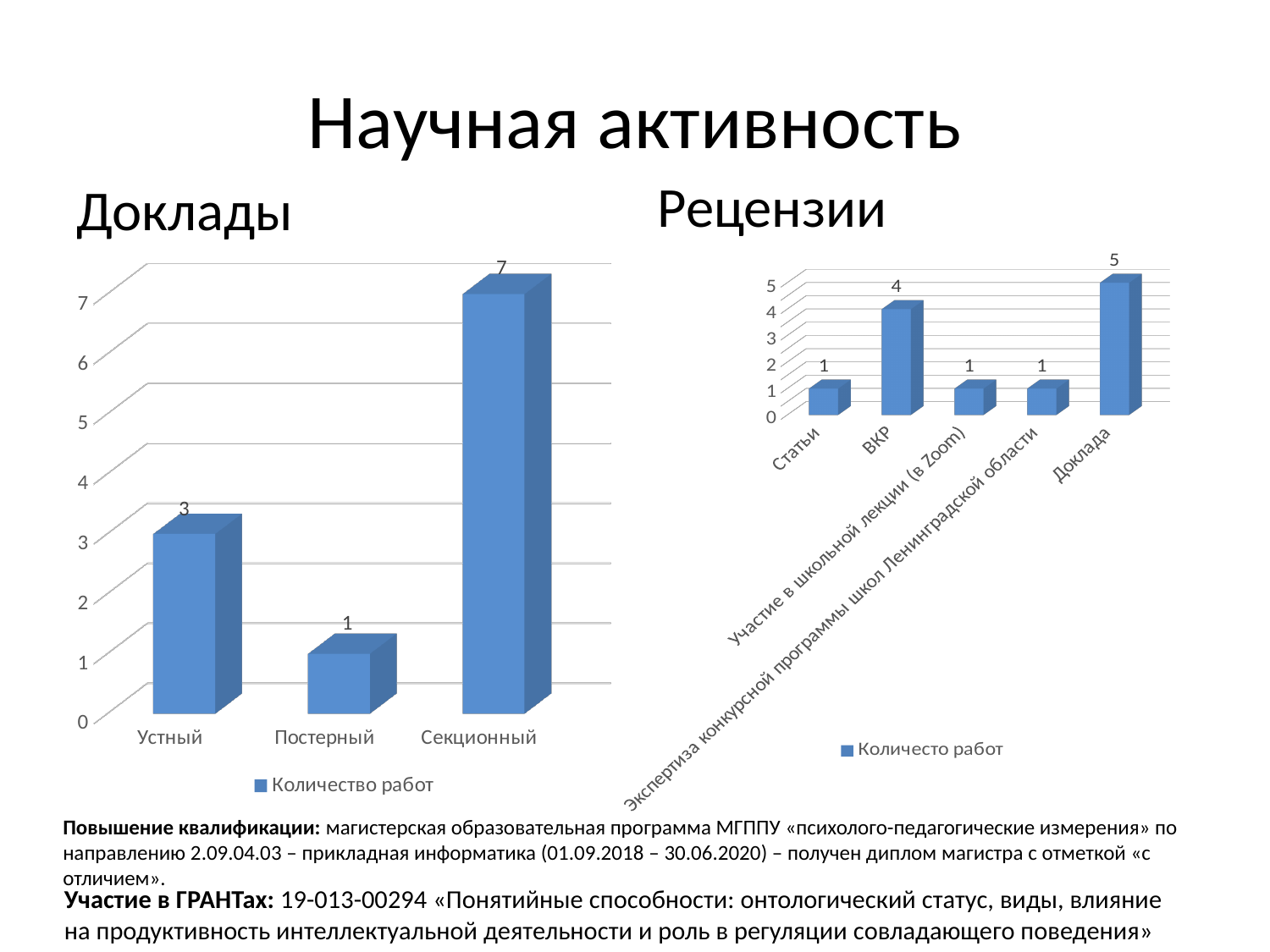
In the "Доклады" chart, what is the value for Устный? 3 How many series does the legend of the "Доклады" chart list? 1 In the "Рецензии" chart, what is the difference between Доклада and ВКР? 1 In the "Доклады" chart, how many categories are shown? 3 In the "Рецензии" chart, how many categories are shown? 5 What kind of chart is the "Доклады" chart? bar chart In the "Рецензии" chart, what is the value for ВКР? 4 In the "Рецензии" chart, which is larger, ВКР or Статьи? ВКР In the "Рецензии" chart, which category has the highest value? Доклада In the "Доклады" chart, what is the value for Секционный? 7 In the "Доклады" chart, what is the difference between Секционный and Устный? 4 In the "Доклады" chart, which category has the lowest value? Постерный